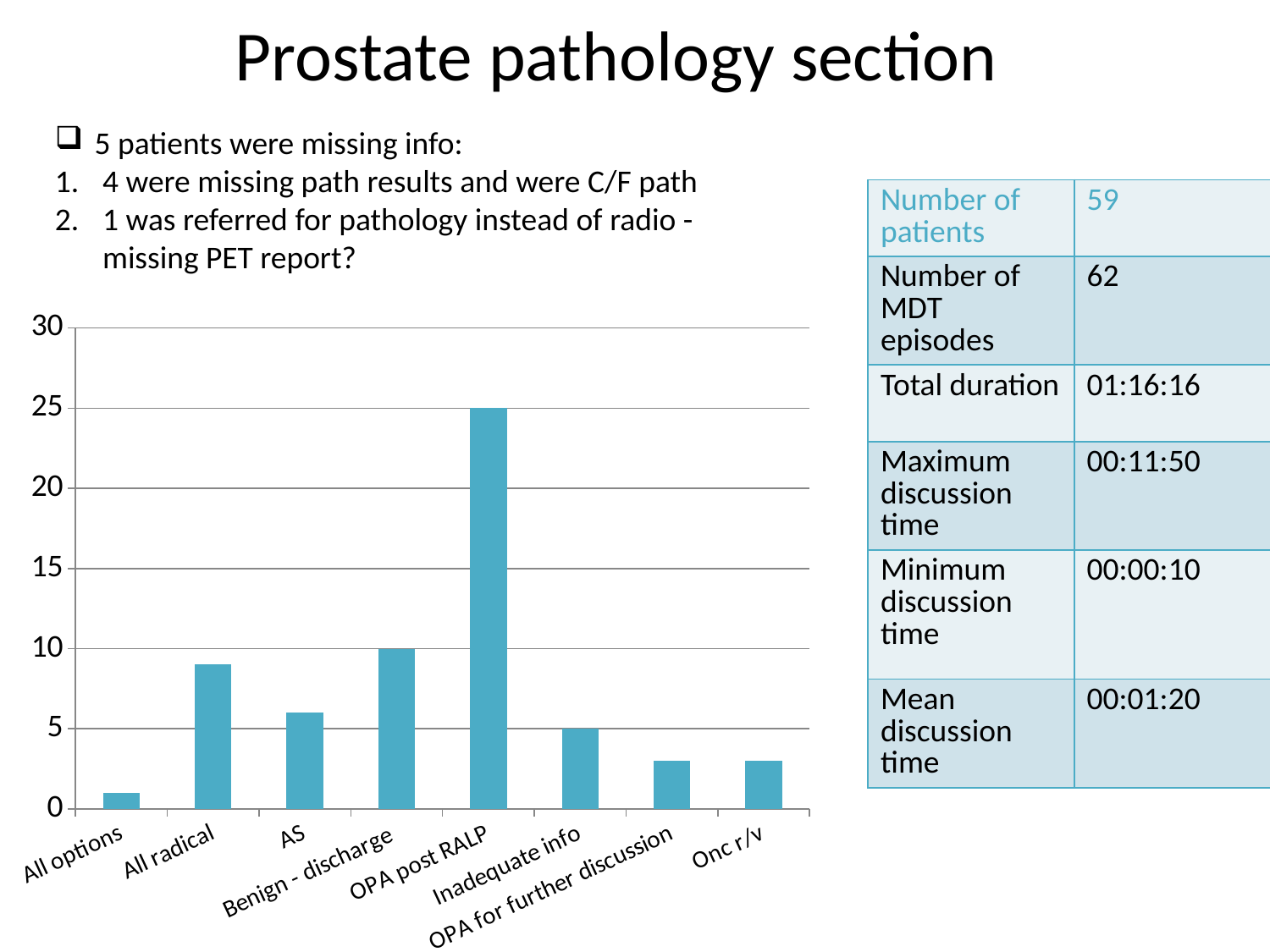
What is the value for OPA post RALP? 25 Which category has the lowest bar in the chart? All options Is the value for All radical greater or less than 10? less What kind of chart is shown on the slide? bar chart Is the value for Onc r/v greater or less than 5? less How many categories are shown on the x axis of the chart? 8 Is the value for AS greater or less than 5? greater Which category has the highest bar in the chart? OPA post RALP What is the difference between the values for OPA post RALP and Benign - discharge? 15 Which is larger, the value for All radical or the value for AS? All radical What is the value for Benign - discharge? 10 What is the value for Inadequate info? 5